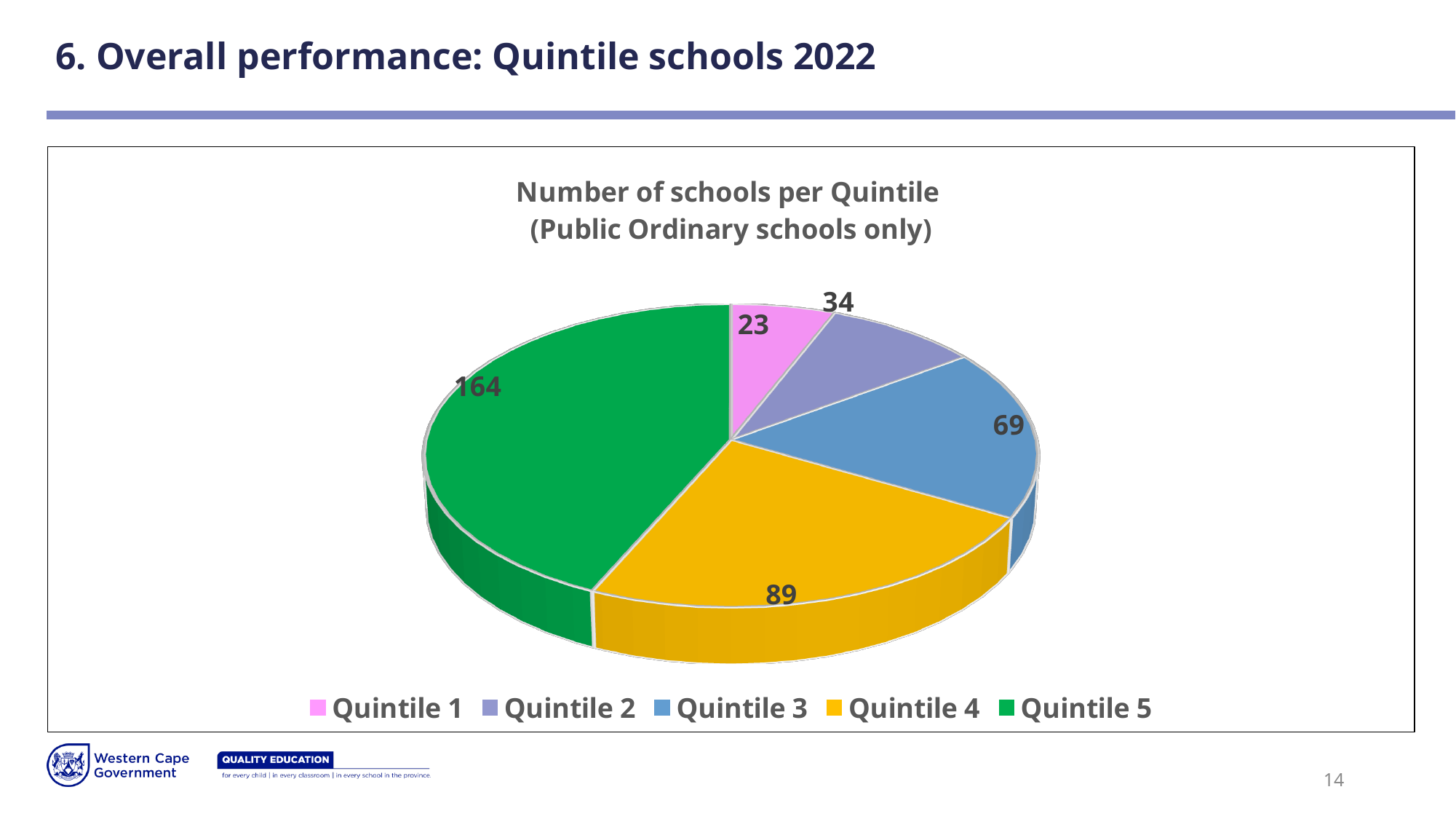
What is the title of the chart? Number of schools per Quintile (Public Ordinary schools only) What is the total number of schools across all five quintiles? 379 Which quintile has the largest number of schools? Quintile 5 What is the value shown for Quintile 3? 69 What is the difference between the number of schools in Quintile 5 and Quintile 4? 75 How many schools are in Quintile 5? 164 How many quintile categories are shown in the pie chart? 5 What type of chart is shown on the slide? Pie chart How many schools are in Quintile 1? 23 What is the difference between the number of schools in Quintile 3 and Quintile 2? 35 Which has more schools, Quintile 4 or Quintile 3? Quintile 4 Which quintile has the smallest number of schools? Quintile 1